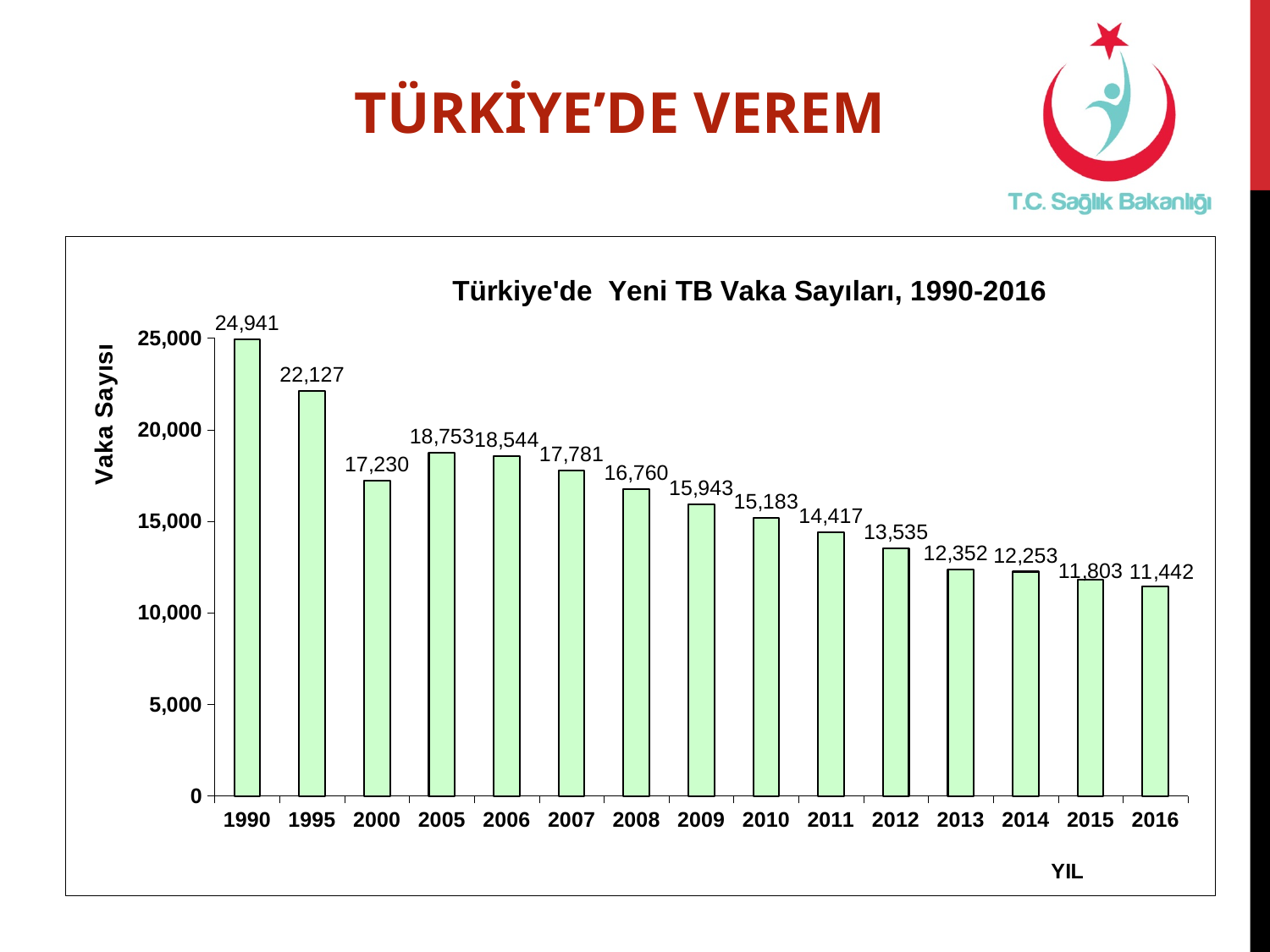
Do the values generally rise or fall from 1990 to 2016? fall What is the difference between the values for 2005 and 2000? 1,523 What is the value for 2010? 15,183 What type of chart is shown on the slide? bar chart Which year has the lowest number of cases? 2016 How many new TB cases are shown for 1990? 24,941 What is the value for 2016? 11,442 What is the difference between the values for 1990 and 2016? 13,499 Which year has the highest number of cases? 1990 What is the title of the chart? Türkiye'de Yeni TB Vaka Sayıları, 1990-2016 Which is larger, the value for 2005 or the value for 2000? 2005 How many years (bars) are shown on the chart? 15